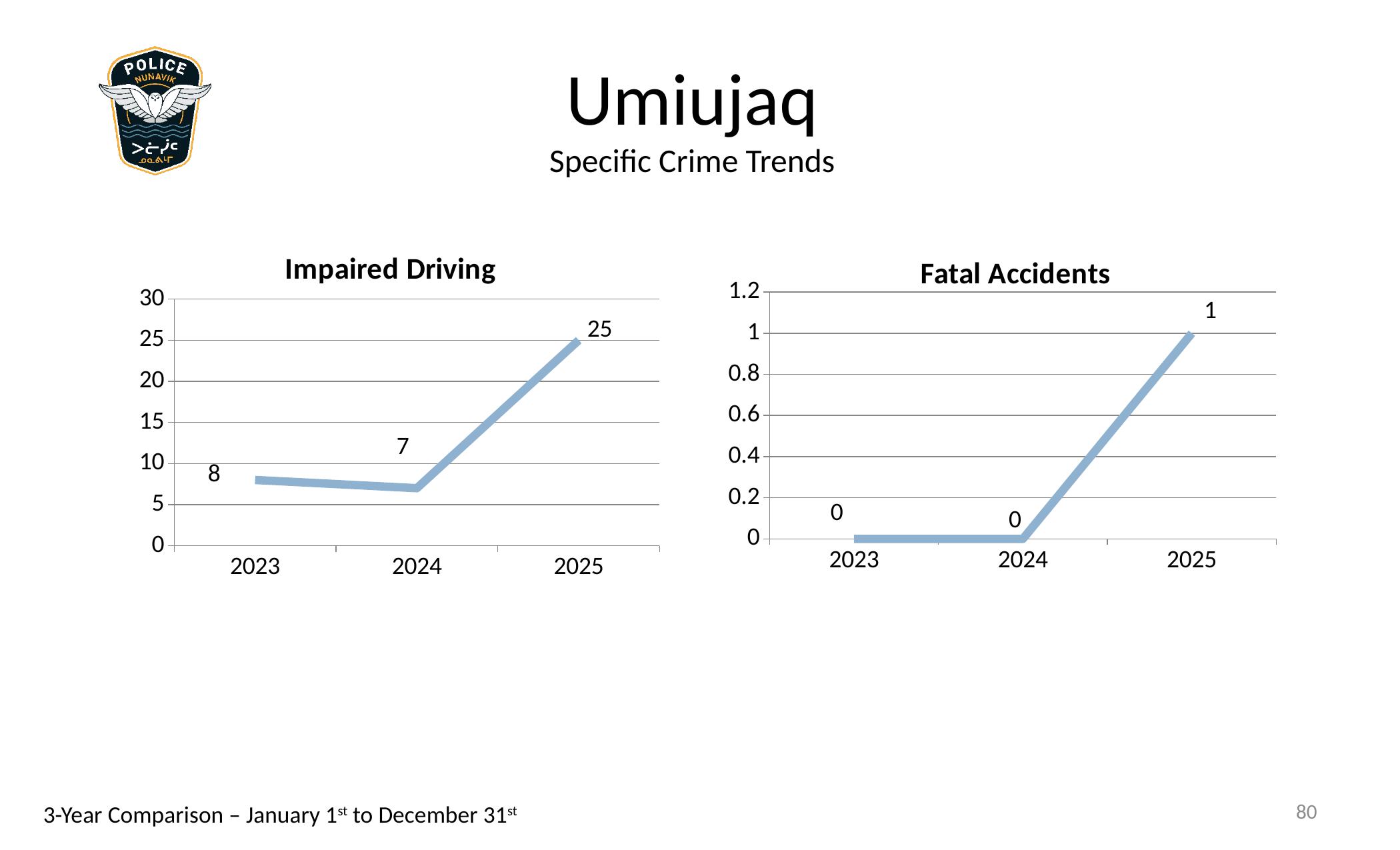
In the Fatal Accidents chart, what is the value for 2025? 1 In the Fatal Accidents chart, which year has the highest value? 2025 In the Impaired Driving chart, which year has the lowest value? 2024 In the Fatal Accidents chart, what is the value for 2023? 0 In the Impaired Driving chart, what is the value for 2024? 7 In the Impaired Driving chart, what is the difference between the 2025 and 2023 values? 17 In the Impaired Driving chart, is the value for 2025 greater or less than 20? greater What kind of chart is the Impaired Driving chart? line chart In the Impaired Driving chart, what is the value for 2025? 25 In the Impaired Driving chart, do the values rise or fall from 2024 to 2025? rise How many years are plotted in the Fatal Accidents chart? 3 In the Impaired Driving chart, which year has the highest value? 2025